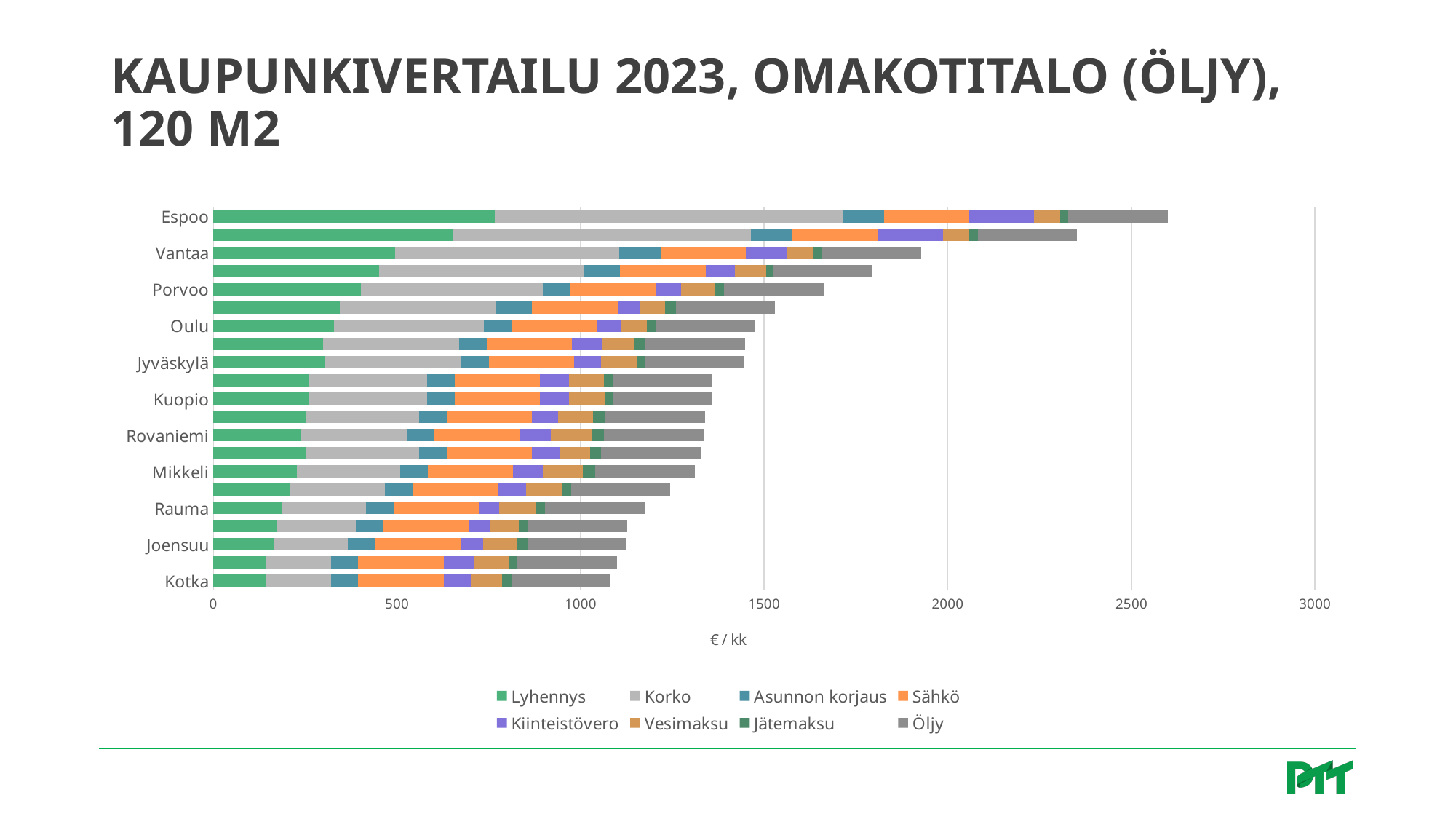
What unit is shown on the x axis label? € / kk Is the total value for Porvoo greater or less than 1500? greater Is the total value for Kuopio greater or less than 1500? less Which has the larger total bar, Espoo or Vantaa? Espoo Is the total value for Kotka greater or less than 1000? greater Which city has the longest total bar? Espoo Which has the larger total bar, Oulu or Rauma? Oulu How many series does the legend list? 8 Do the total bar lengths increase or decrease going down the chart from Espoo to Kotka? decrease What kind of chart is shown on the slide? Stacked bar chart